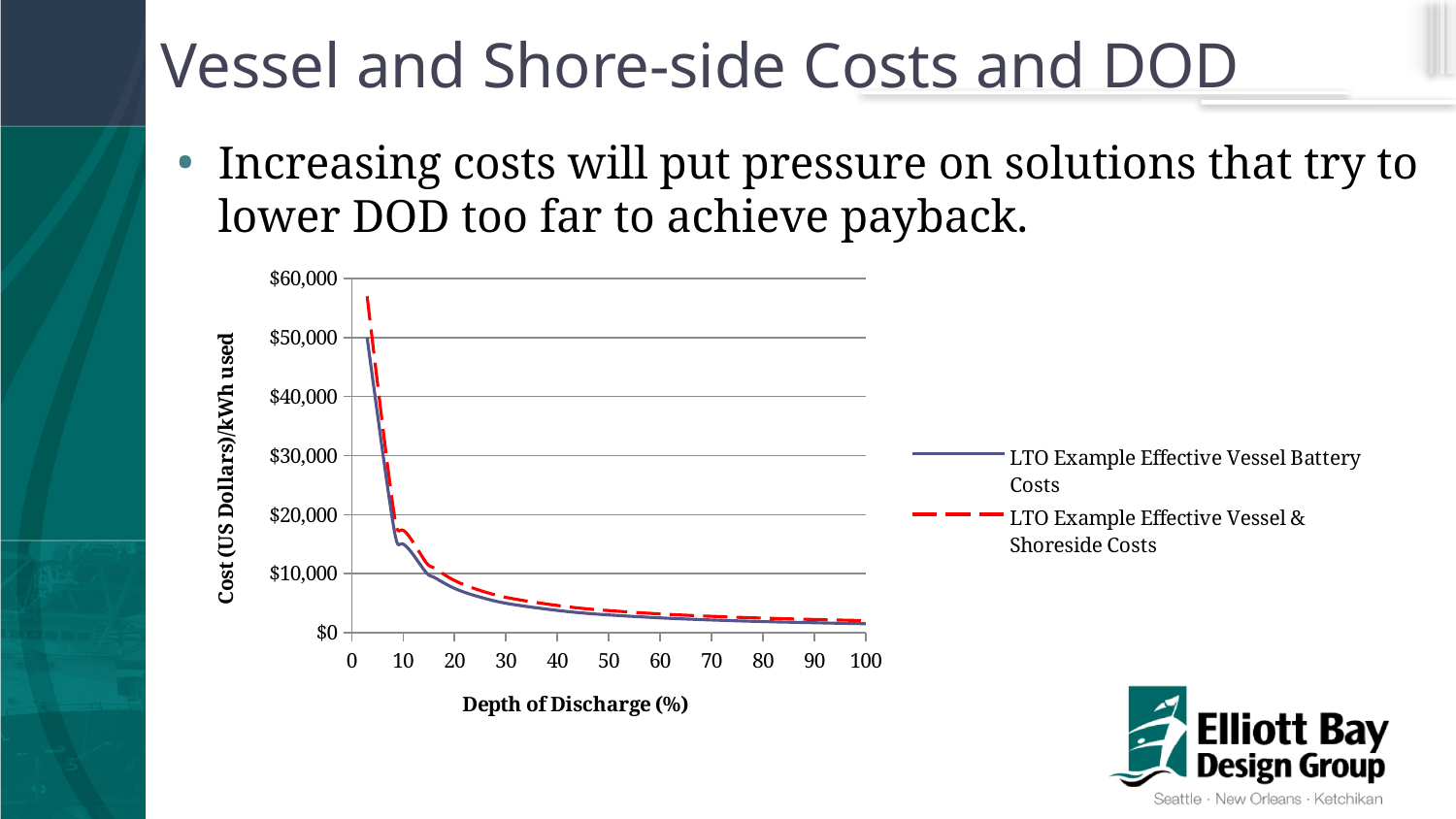
Do the cost values rise or fall as Depth of Discharge increases along the x axis? fall What kind of chart is shown on the slide? line chart How many tick labels are shown on the x axis of the chart? 11 Which series is drawn with a dashed line? LTO Example Effective Vessel & Shoreside Costs Is the value for LTO Example Effective Vessel Battery Costs at a Depth of Discharge of 10% greater or less than $10,000? greater Is the value for LTO Example Effective Vessel & Shoreside Costs at a Depth of Discharge of 10% greater or less than $20,000? less Which series is higher at a Depth of Discharge of 20%: LTO Example Effective Vessel Battery Costs or LTO Example Effective Vessel & Shoreside Costs? LTO Example Effective Vessel & Shoreside Costs Is the value for LTO Example Effective Vessel Battery Costs at a Depth of Discharge of 100% greater or less than $10,000? less How many series does the chart legend list? 2 What is the title of the chart's x axis? Depth of Discharge (%) What is the title of the chart's y axis? Cost (US Dollars)/kWh used